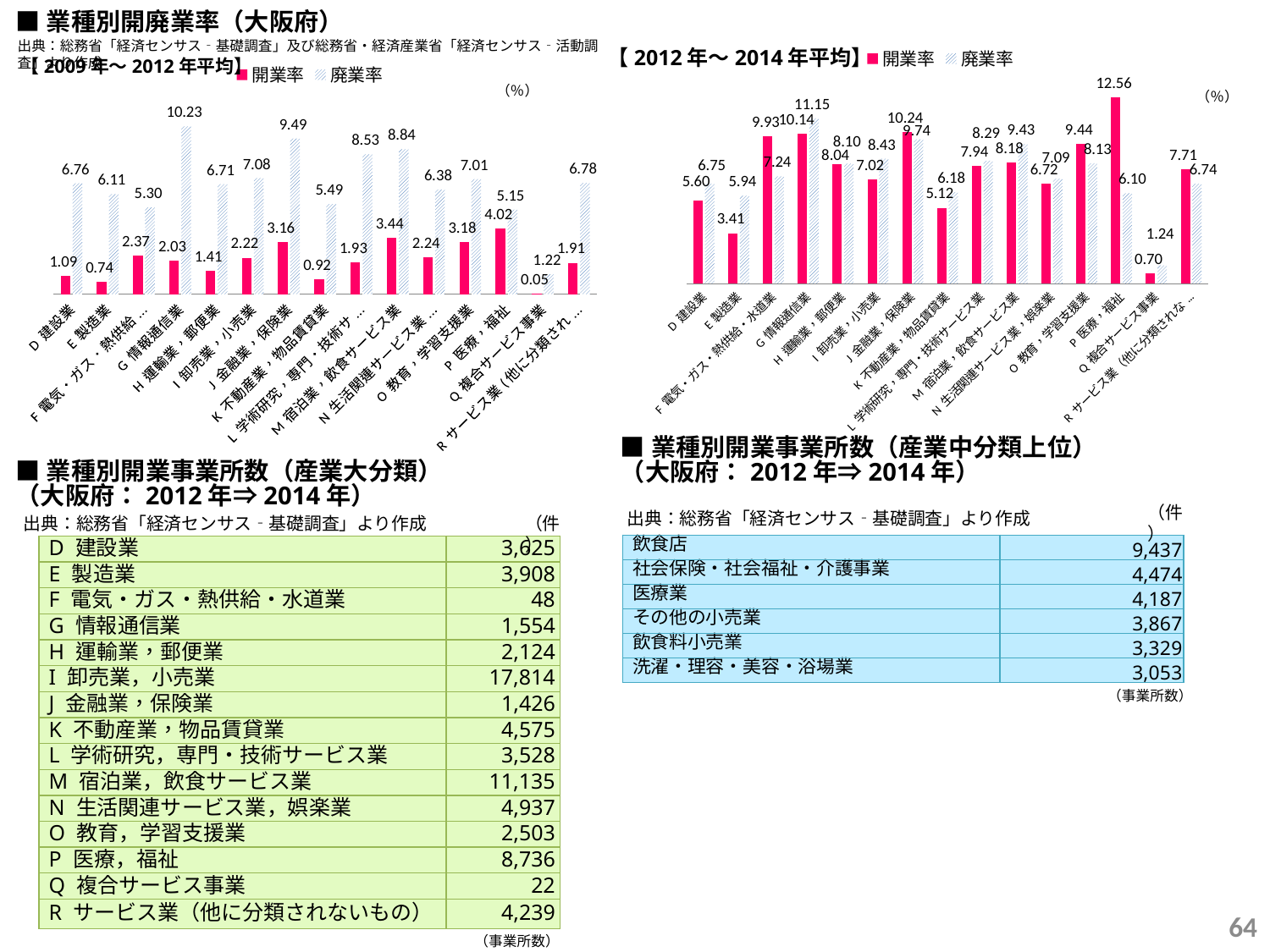
How many industry categories are plotted in the left chart (2009年～2012年平均)? 15 In the left chart (2009年～2012年平均), which category has the highest 廃業率? G 情報通信業 In the left chart (2009年～2012年平均), what is the 廃業率 for G 情報通信業? 10.23 In the left chart (2009年～2012年平均), what is the difference between the 廃業率 and 開業率 for J 金融業，保険業? 6.33 What type of chart is the right chart (2012年～2014年平均)? Bar chart In the right chart (2012年～2014年平均), what is the 開業率 for P 医療，福祉? 12.56 In the right chart (2012年～2014年平均), which category has the highest 開業率? P 医療，福祉 How many series does the legend of the right chart (2012年～2014年平均) list? 2 In the left chart (2009年～2012年平均), which category has the lowest 開業率? Q 複合サービス事業 In the left chart (2009年～2012年平均), what is the 開業率 for P 医療，福祉? 4.02 In the right chart (2012年～2014年平均), which is larger for D 建設業, the 開業率 or the 廃業率? 廃業率 In the right chart (2012年～2014年平均), what is the 廃業率 for Q 複合サービス事業? 1.24